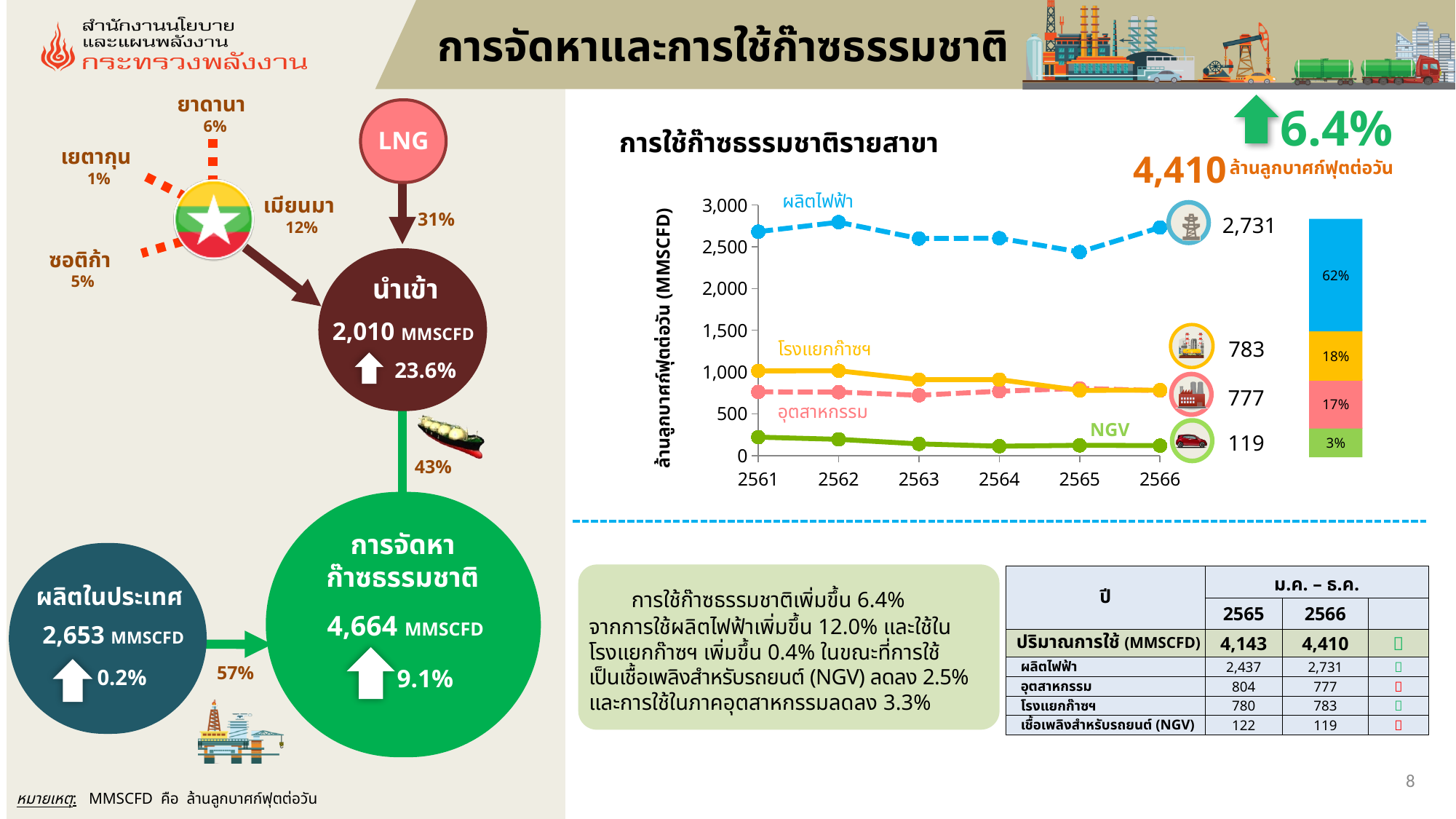
In the chart การใช้ก๊าซธรรมชาติรายสาขา, which series has the highest value in 2566? ผลิตไฟฟ้า In the chart การใช้ก๊าซธรรมชาติรายสาขา, what is the value for โรงแยกก๊าซฯ in 2566? 783 In the chart การใช้ก๊าซธรรมชาติรายสาขา, what is the value for NGV in 2566? 119 How many years are shown on the x axis of the chart การใช้ก๊าซธรรมชาติรายสาขา? 6 In the chart การใช้ก๊าซธรรมชาติรายสาขา, what is the difference between the 2566 values for ผลิตไฟฟ้า and โรงแยกก๊าซฯ? 1,948 In the chart การใช้ก๊าซธรรมชาติรายสาขา, what is the value for ผลิตไฟฟ้า in 2566? 2,731 In the chart การใช้ก๊าซธรรมชาติรายสาขา, is the value for ผลิตไฟฟ้า in 2562 greater or less than 2,500? greater In the chart การใช้ก๊าซธรรมชาติรายสาขา, which is larger in 2566: อุตสาหกรรม or NGV? อุตสาหกรรม In the chart การใช้ก๊าซธรรมชาติรายสาขา, is the value for NGV in 2561 greater or less than 500? less What kind of chart is การใช้ก๊าซธรรมชาติรายสาขา? line chart In the chart การใช้ก๊าซธรรมชาติรายสาขา, which series has the lowest value in 2566? NGV In the chart การใช้ก๊าซธรรมชาติรายสาขา, does the NGV line rise or fall from 2561 to 2566? fall